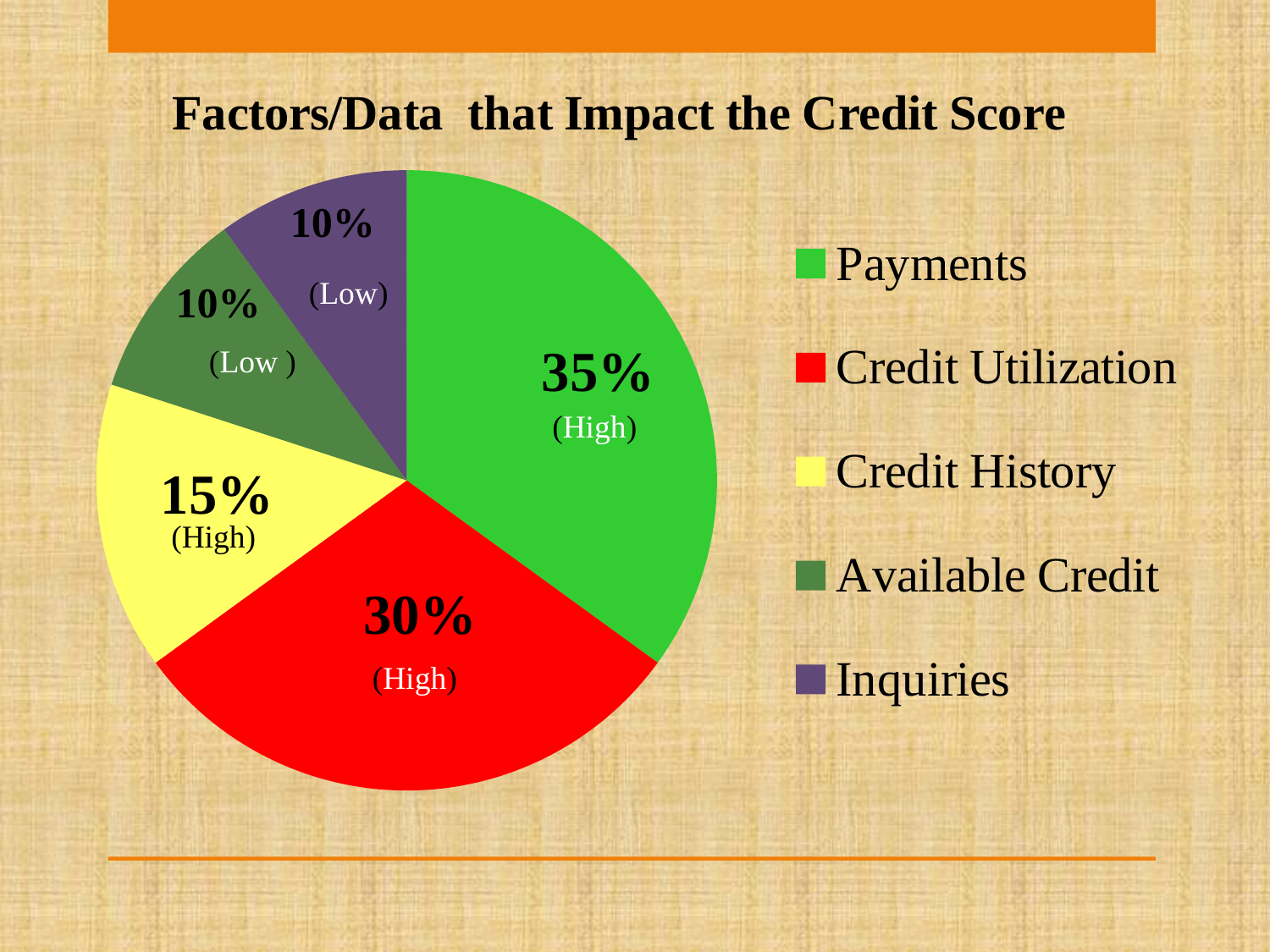
What percentage of the pie is Credit History? 15% How many slices does the pie chart have? 5 What percentage of the pie is Credit Utilization? 30% What percentage of the pie is Available Credit? 10% What percentage of the pie is Payments? 35% Which is larger, Credit History or Credit Utilization? Credit Utilization Which factor has the largest share of the pie? Payments What is the difference in percentage points between Payments and Credit Utilization? 5 What kind of chart is shown on the slide? pie chart What colour is the Inquiries slice? purple How many entries does the legend list? 5 What is the title of the chart? Factors/Data that Impact the Credit Score